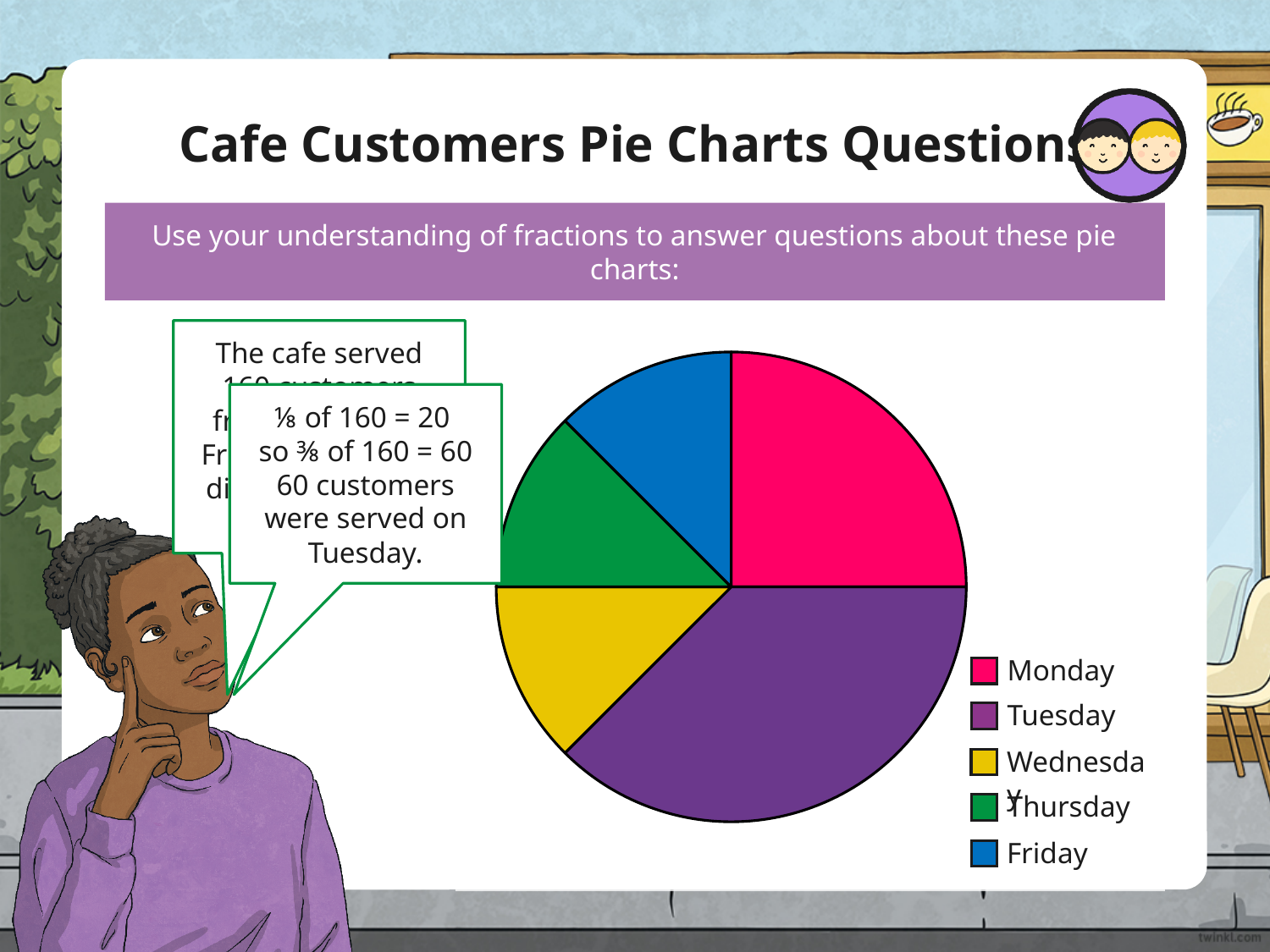
What kind of chart is shown on the slide? pie chart How many slices does the pie chart have? 5 Which day has the largest slice of the pie chart? Tuesday Which slice is larger, Monday or Tuesday? Tuesday According to the speech bubble, how many customers did the cafe serve in total? 160 What is the title of the slide? Cafe Customers Pie Charts Questions According to the speech bubble, what fraction of the customers were served on Tuesday? ⅜ What colour is the Monday slice in the pie chart? pink According to the speech bubble, how many customers were served on Tuesday? 60 Which slice is larger, Tuesday or Wednesday? Tuesday How many entries does the legend list? 5 Which slice is larger, Monday or Friday? Monday